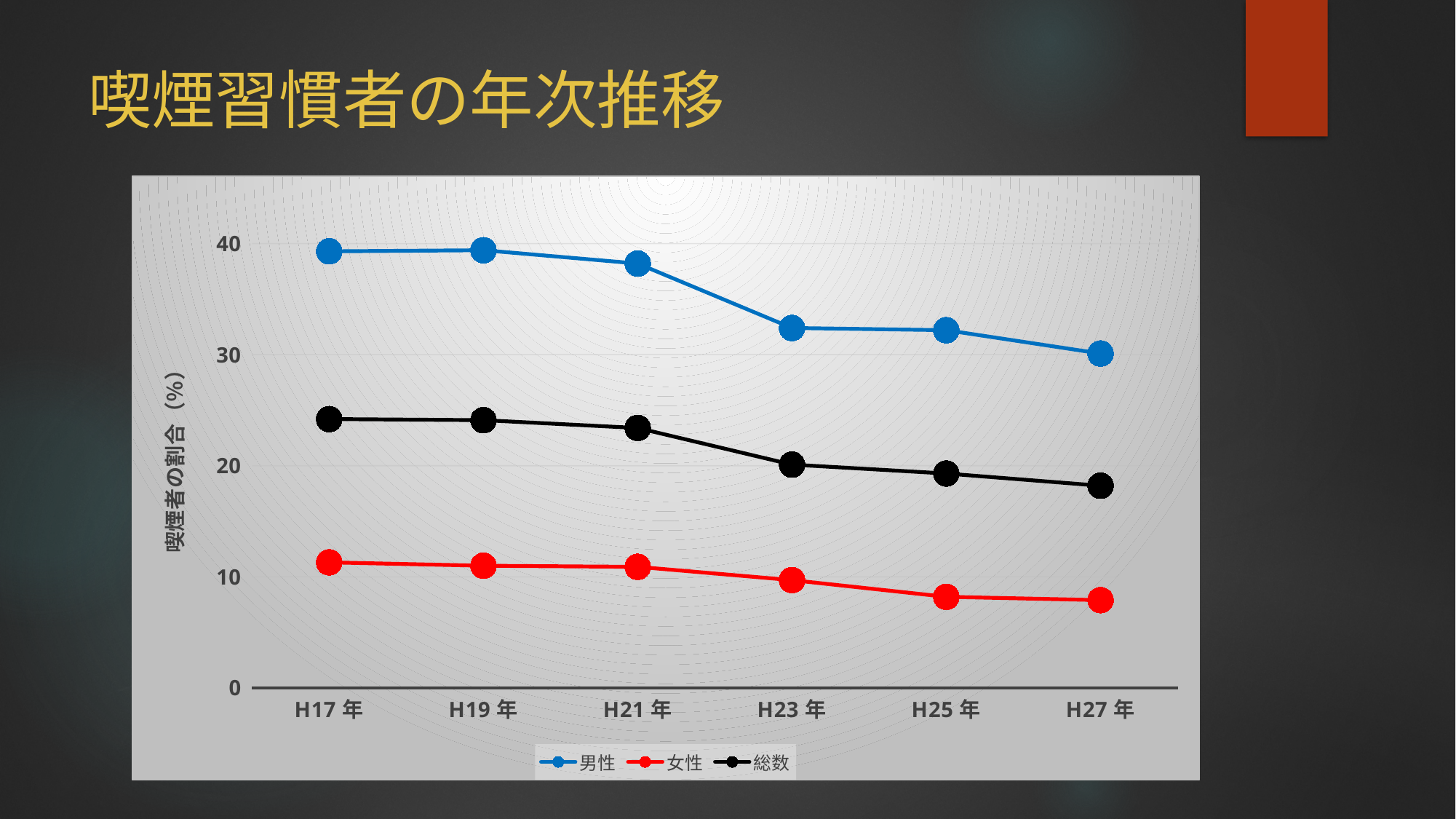
What is the title of the chart on the slide? 喫煙習慣者の年次推移 How many series does the legend list? 3 Is the value for 総数 in H27年 greater or less than 20? less Is the value for 女性 in H27年 greater or less than 10? less What kind of chart is shown on the slide? line chart How many years are plotted along the x axis? 6 Is the value for 男性 in H17年 greater or less than 30? greater Which is larger, the value for 男性 in H21年 or the value for 男性 in H23年? H21年 Do the values for 総数 rise or fall from H17年 to H27年? fall Do the values for 男性 rise or fall from H17年 to H27年? fall Which series has the highest values throughout the chart? 男性 Which series has the lowest values throughout the chart? 女性